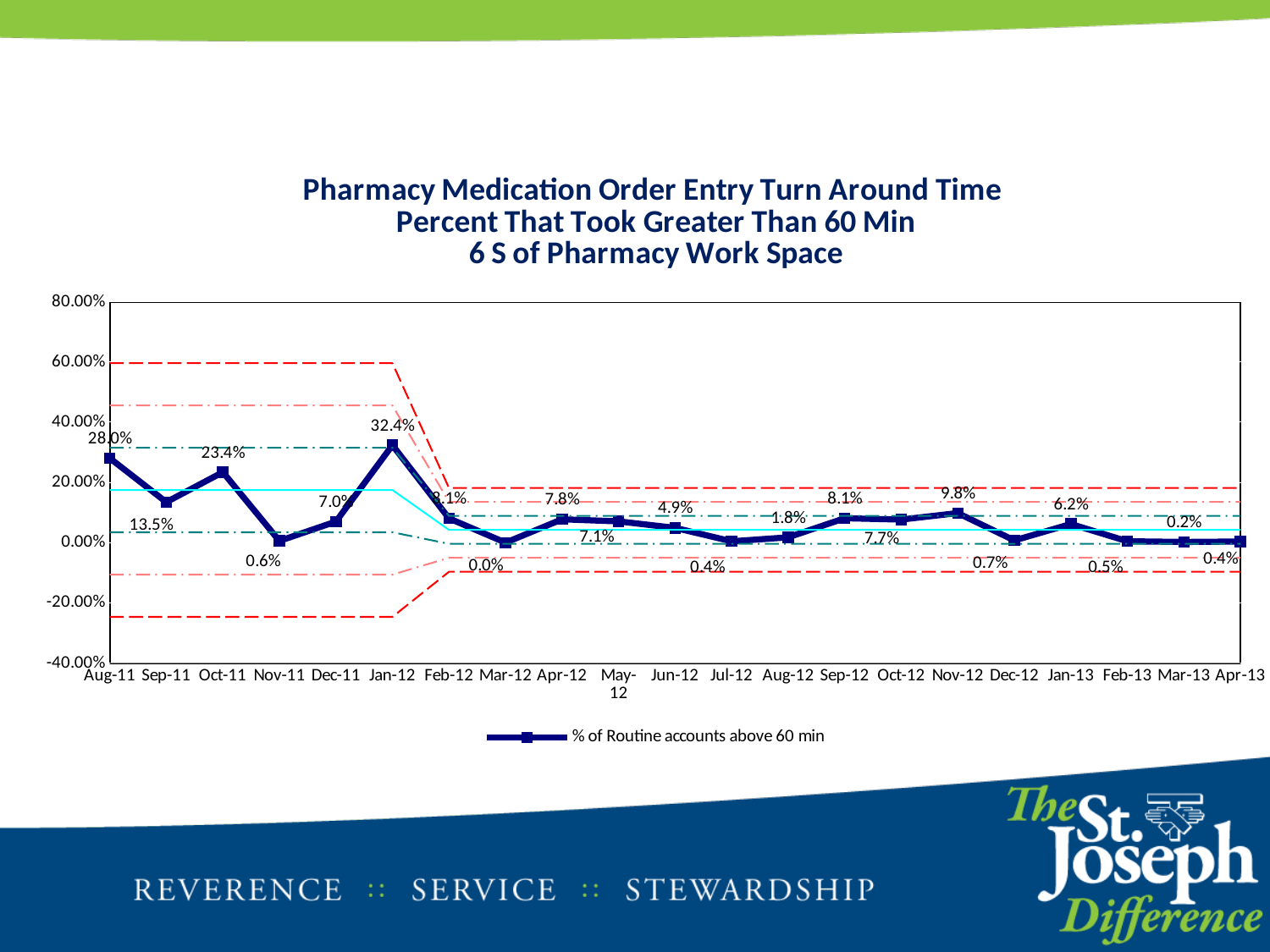
How many series does the legend list? 1 What is the value for Nov-12? 9.8% Is the value for Jan-12 greater or less than 20.00%? greater Which month has the lowest value? Mar-12 What is the value for Jan-12? 32.4% What is the value for Aug-11? 28.0% Which is larger, the value for Oct-11 or the value for Sep-11? Oct-11 How many months are plotted on the x axis? 21 What is the difference between the values for Jan-12 and Aug-11? 4.4% What kind of chart is shown? Line chart Which month has the highest value? Jan-12 What is the value for Mar-13? 0.2%